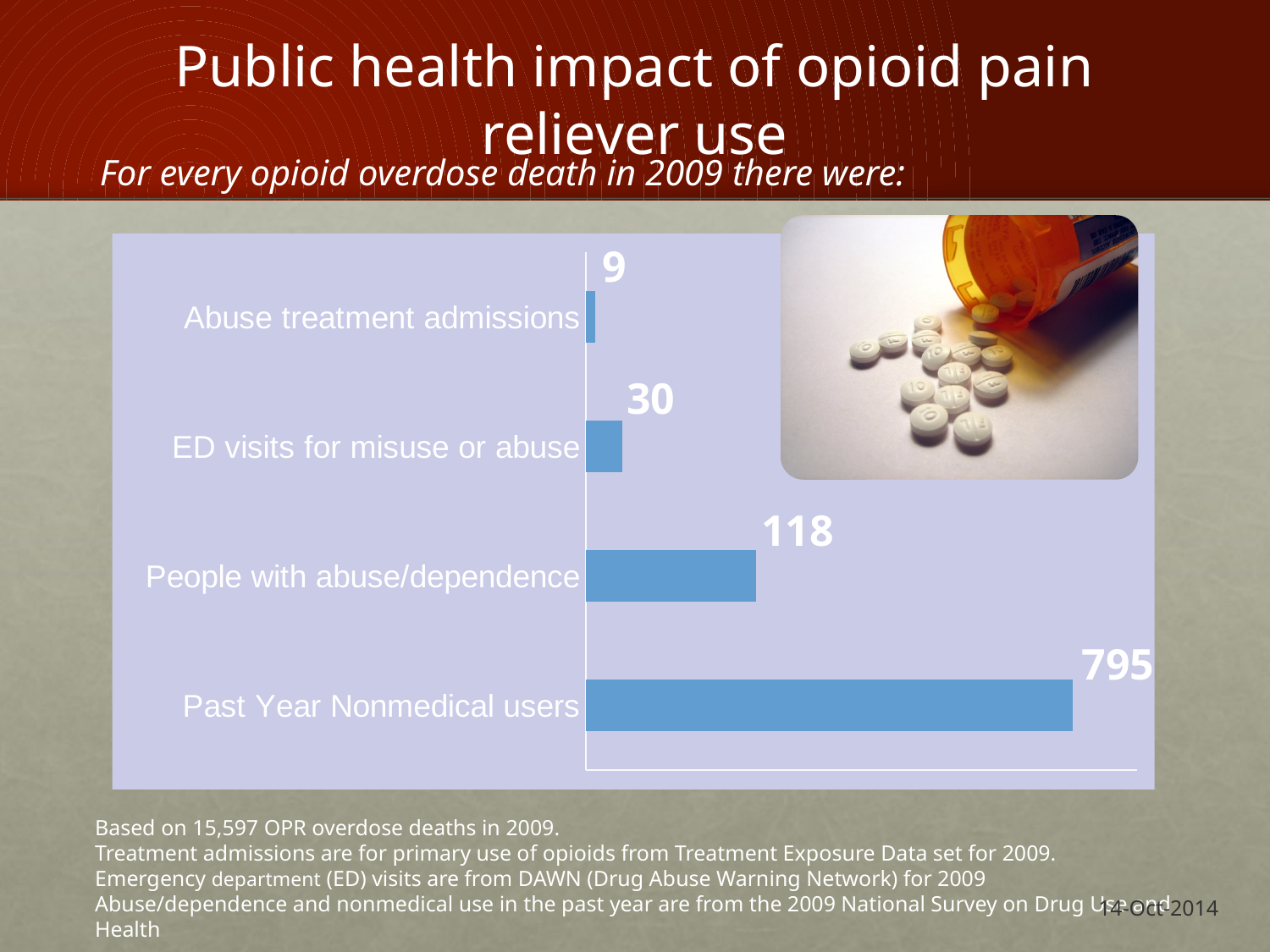
What is the difference between the values for ED visits for misuse or abuse and Abuse treatment admissions? 21 What is the difference between the values for Past Year Nonmedical users and People with abuse/dependence? 677 Which category has the lowest value? Abuse treatment admissions What kind of chart is shown on the slide? Bar chart What is the value for ED visits for misuse or abuse? 30 What colour are the bars in the chart? Blue What is the value for Past Year Nonmedical users? 795 Which is larger, the value for ED visits for misuse or abuse or the value for People with abuse/dependence? People with abuse/dependence What is the value for Abuse treatment admissions? 9 Which category has the highest value? Past Year Nonmedical users How many categories are shown in the chart? 4 What is the value for People with abuse/dependence? 118